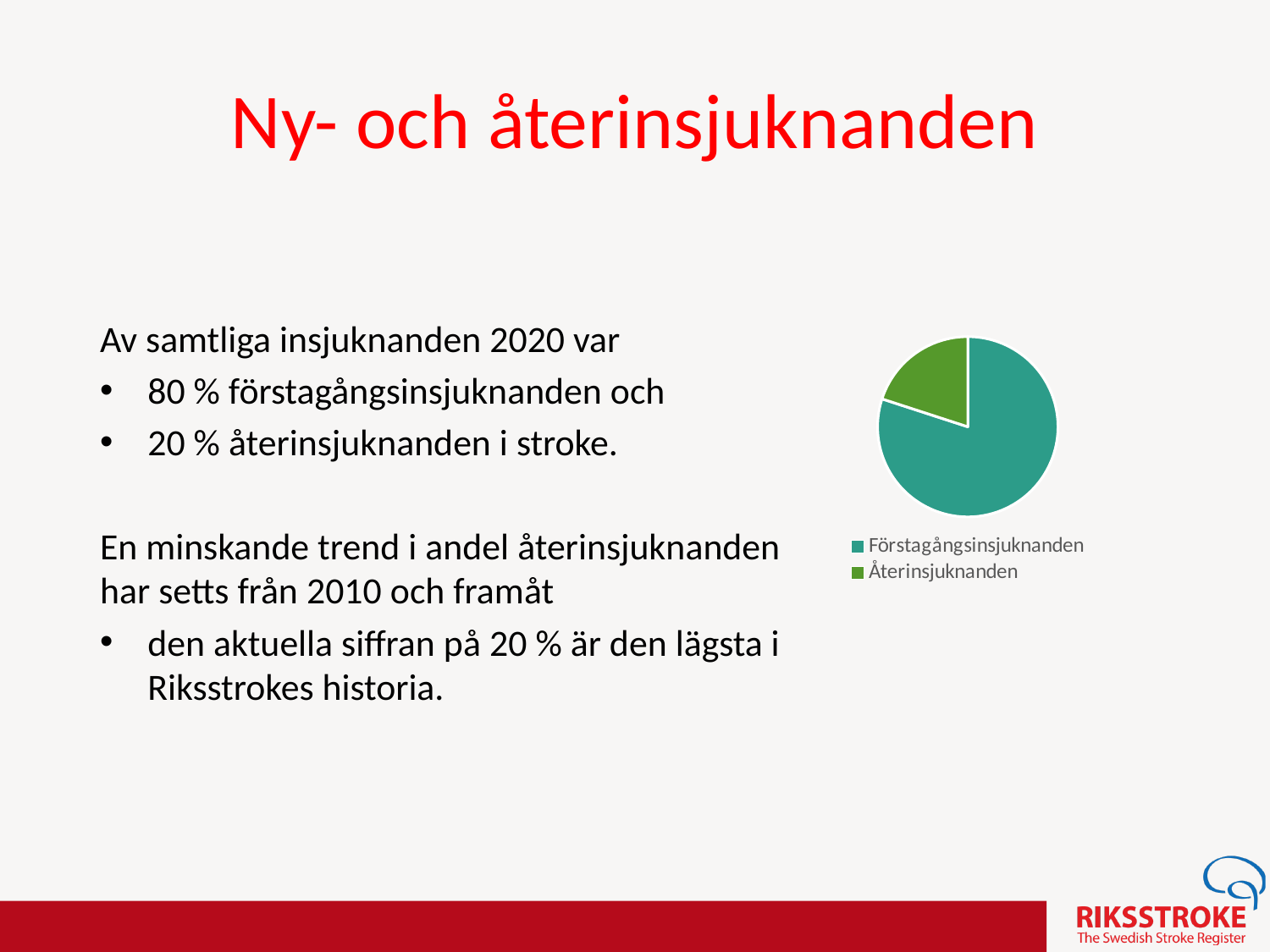
What colour is the Återinsjuknanden slice in the pie chart? green What share of the pie does Återinsjuknanden represent? 20 % Which slice of the pie chart is the smallest? Återinsjuknanden What share of the pie does Förstagångsinsjuknanden represent? 80 % Which is larger in the pie chart, Förstagångsinsjuknanden or Återinsjuknanden? Förstagångsinsjuknanden How many slices does the pie chart have? 2 What kind of chart is shown on the slide? pie chart Which slice of the pie chart is the largest? Förstagångsinsjuknanden How many entries does the legend of the pie chart list? 2 What is the first entry listed in the pie chart's legend? Förstagångsinsjuknanden